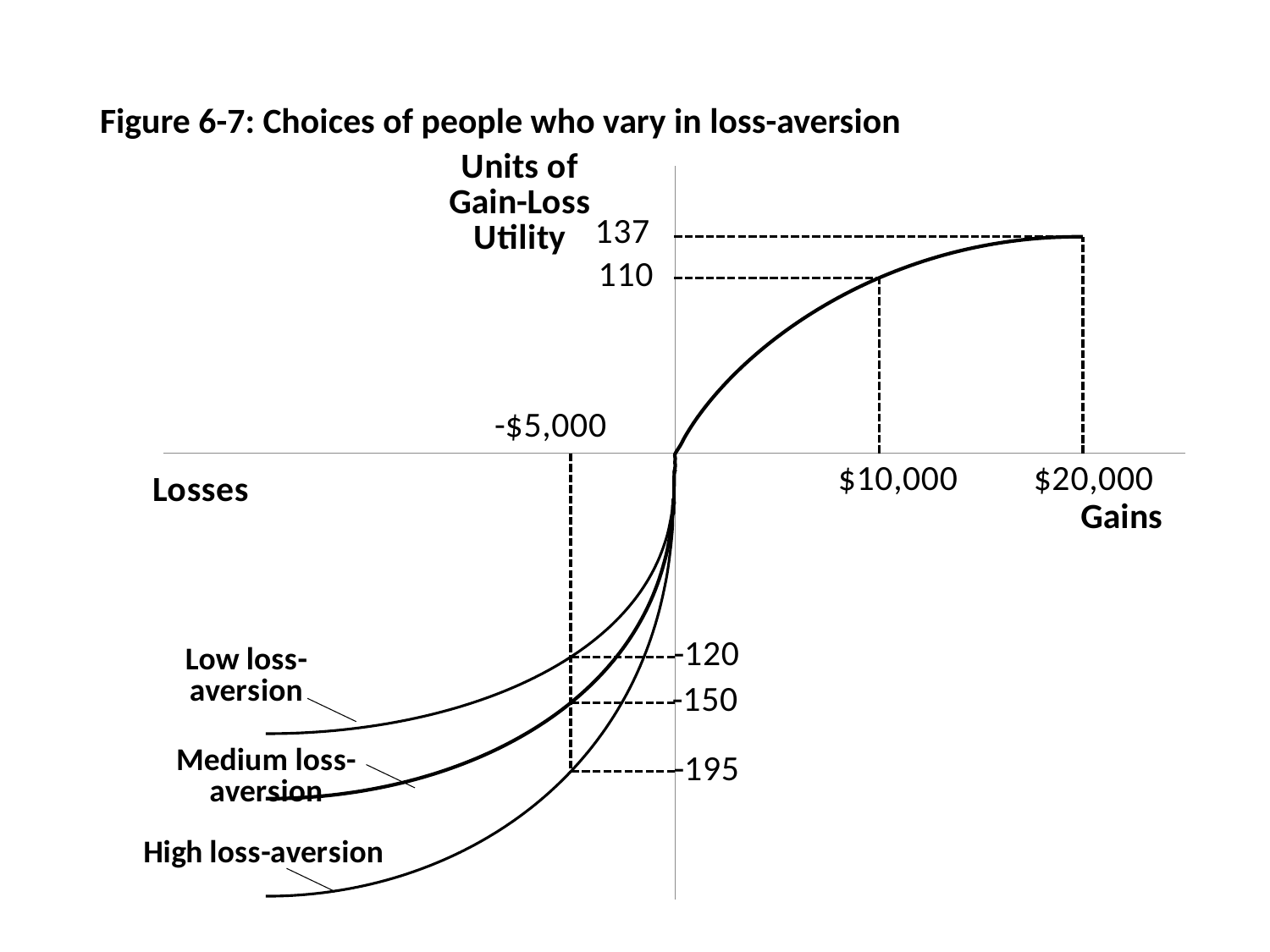
For the low loss-aversion curve, how many units of gain-loss utility are marked at a loss of -$5,000? 120 How many units of gain-loss utility correspond to a gain of $20,000? 137 For the medium loss-aversion curve, how many units of gain-loss utility are marked at a loss of -$5,000? 150 What kind of chart is shown on the slide? line chart How many loss-aversion curves are drawn on the losses side of the chart? 3 How many units of gain-loss utility correspond to a gain of $10,000? 110 What is the title of the figure on the slide? Figure 6-7: Choices of people who vary in loss-aversion For the high loss-aversion curve, how many units of gain-loss utility are marked at a loss of -$5,000? 195 What is the difference in utility units between a gain of $20,000 and a gain of $10,000? 27 At a loss of -$5,000, what is the difference in utility units between the high loss-aversion and low loss-aversion curves? 75 At a loss of -$5,000, which curve shows the larger number of utility units: high loss-aversion or low loss-aversion? High loss-aversion At a loss of -$5,000, what is the difference in utility units between the medium loss-aversion and low loss-aversion curves? 30